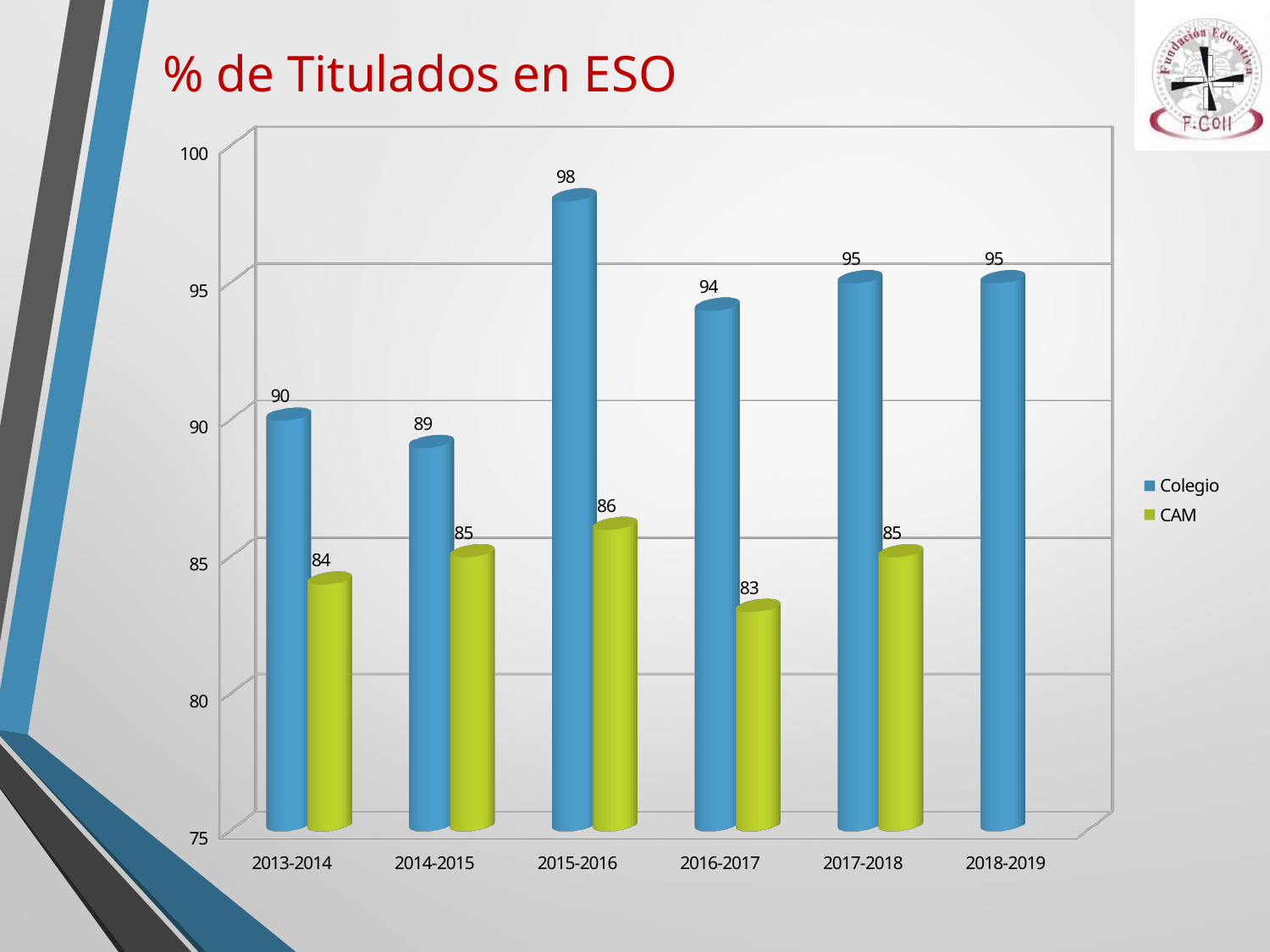
What is the Colegio value for 2018-2019? 95 What is the Colegio value for 2015-2016? 98 Which is larger in 2014-2015, the Colegio value or the CAM value? Colegio Which school year has the highest Colegio value? 2015-2016 How many school years are shown on the x axis? 6 What kind of chart is shown on the slide? bar chart Which school year has the lowest CAM value? 2016-2017 What is the difference between the Colegio and CAM values in 2015-2016? 12 Is the Colegio value for 2013-2014 greater or less than 95? less How many series does the legend list? 2 What is the title of the chart? % de Titulados en ESO What is the CAM value for 2016-2017? 83